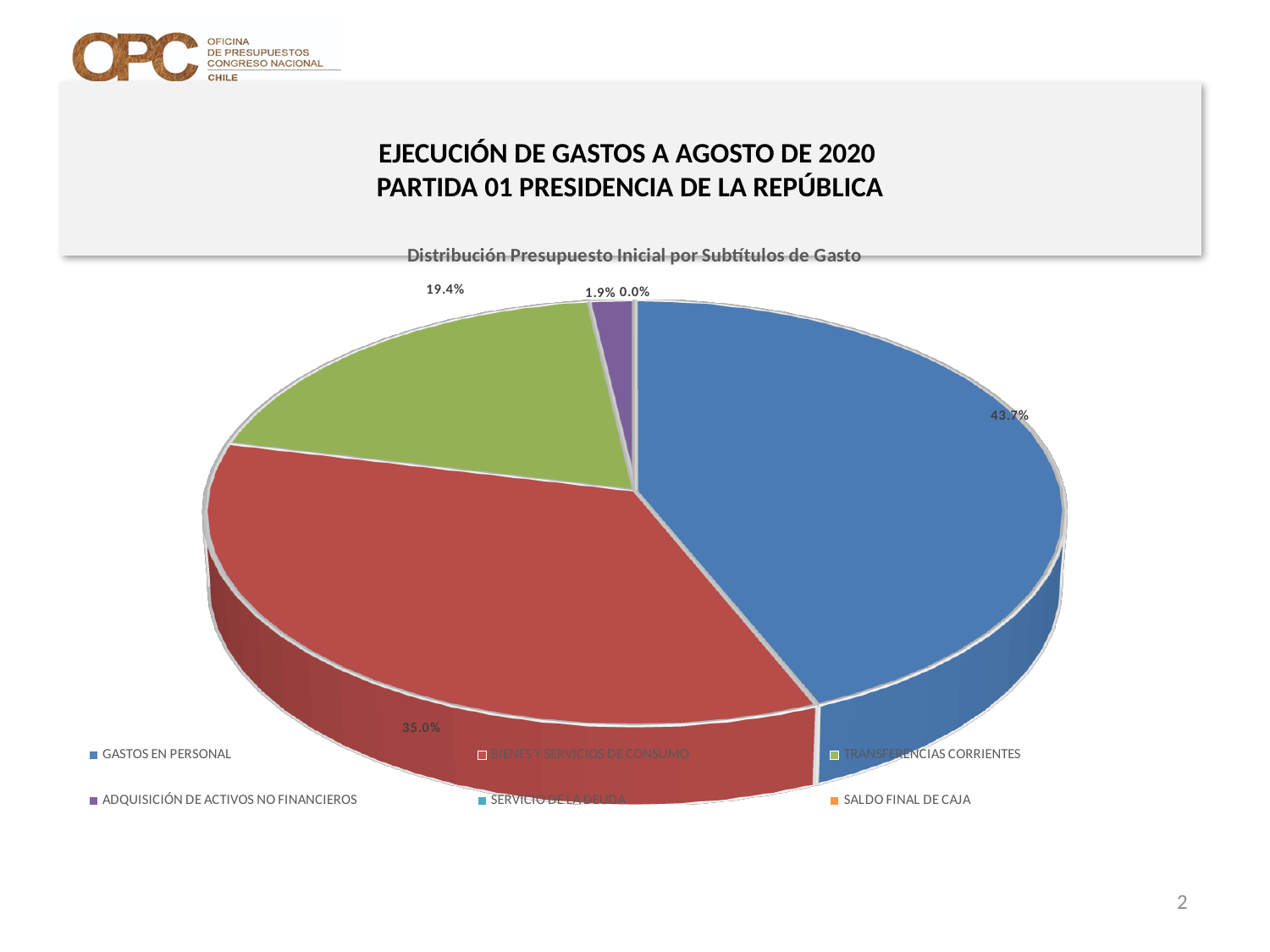
What kind of chart is shown on the slide? pie chart What colour is the slice for GASTOS EN PERSONAL? blue What share of the pie does TRANSFERENCIAS CORRIENTES represent? 19.4% How many entries does the chart legend list? 6 What share of the pie does ADQUISICIÓN DE ACTIVOS NO FINANCIEROS represent? 1.9% What share of the pie does GASTOS EN PERSONAL represent? 43.7% Which is larger, the share for BIENES Y SERVICIOS DE CONSUMO or the share for TRANSFERENCIAS CORRIENTES? BIENES Y SERVICIOS DE CONSUMO What is the title of the chart? Distribución Presupuesto Inicial por Subtítulos de Gasto What is the difference between the shares of GASTOS EN PERSONAL and BIENES Y SERVICIOS DE CONSUMO? 8.7% Which category has the largest share of the pie? GASTOS EN PERSONAL What is the difference between the shares of TRANSFERENCIAS CORRIENTES and ADQUISICIÓN DE ACTIVOS NO FINANCIEROS? 17.5%